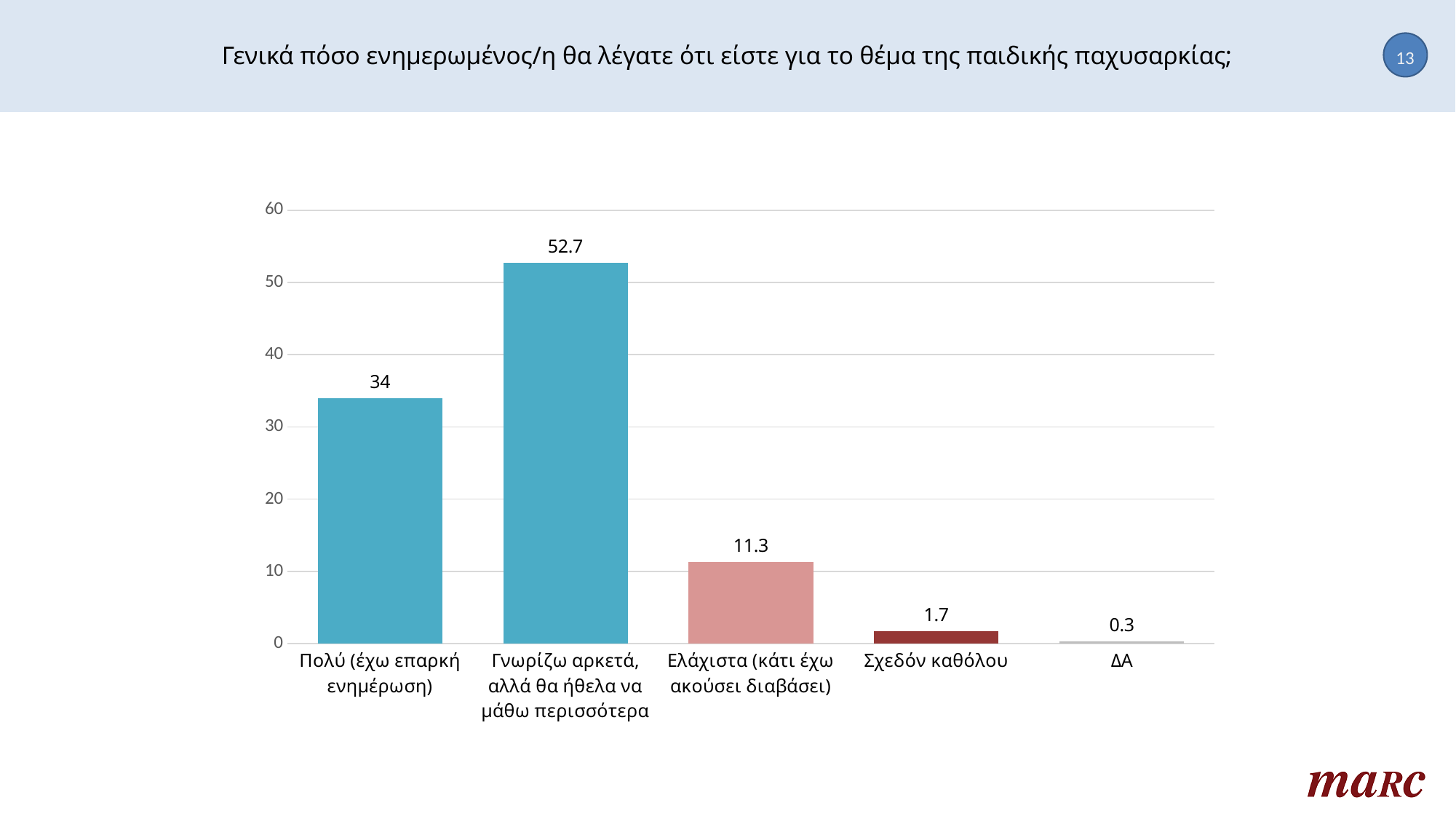
What is the value for 'Πολύ (έχω επαρκή ενημέρωση)'? 34 What is the value for 'ΔΑ'? 0.3 What is the difference between the values for 'Γνωρίζω αρκετά, αλλά θα ήθελα να μάθω περισσότερα' and 'Πολύ (έχω επαρκή ενημέρωση)'? 18.7 Which category has the lowest value? ΔΑ What is the value for 'Γνωρίζω αρκετά, αλλά θα ήθελα να μάθω περισσότερα'? 52.7 Which is larger, the value for 'Ελάχιστα (κάτι έχω ακούσει διαβάσει)' or the value for 'Σχεδόν καθόλου'? Ελάχιστα (κάτι έχω ακούσει διαβάσει) How many categories are shown on the x axis? 5 Which category has the highest value? Γνωρίζω αρκετά, αλλά θα ήθελα να μάθω περισσότερα What kind of chart is shown on the slide? bar chart What is the value for 'Ελάχιστα (κάτι έχω ακούσει διαβάσει)'? 11.3 What is the value for 'Σχεδόν καθόλου'? 1.7 Is the value for 'Πολύ (έχω επαρκή ενημέρωση)' greater or less than 30? greater